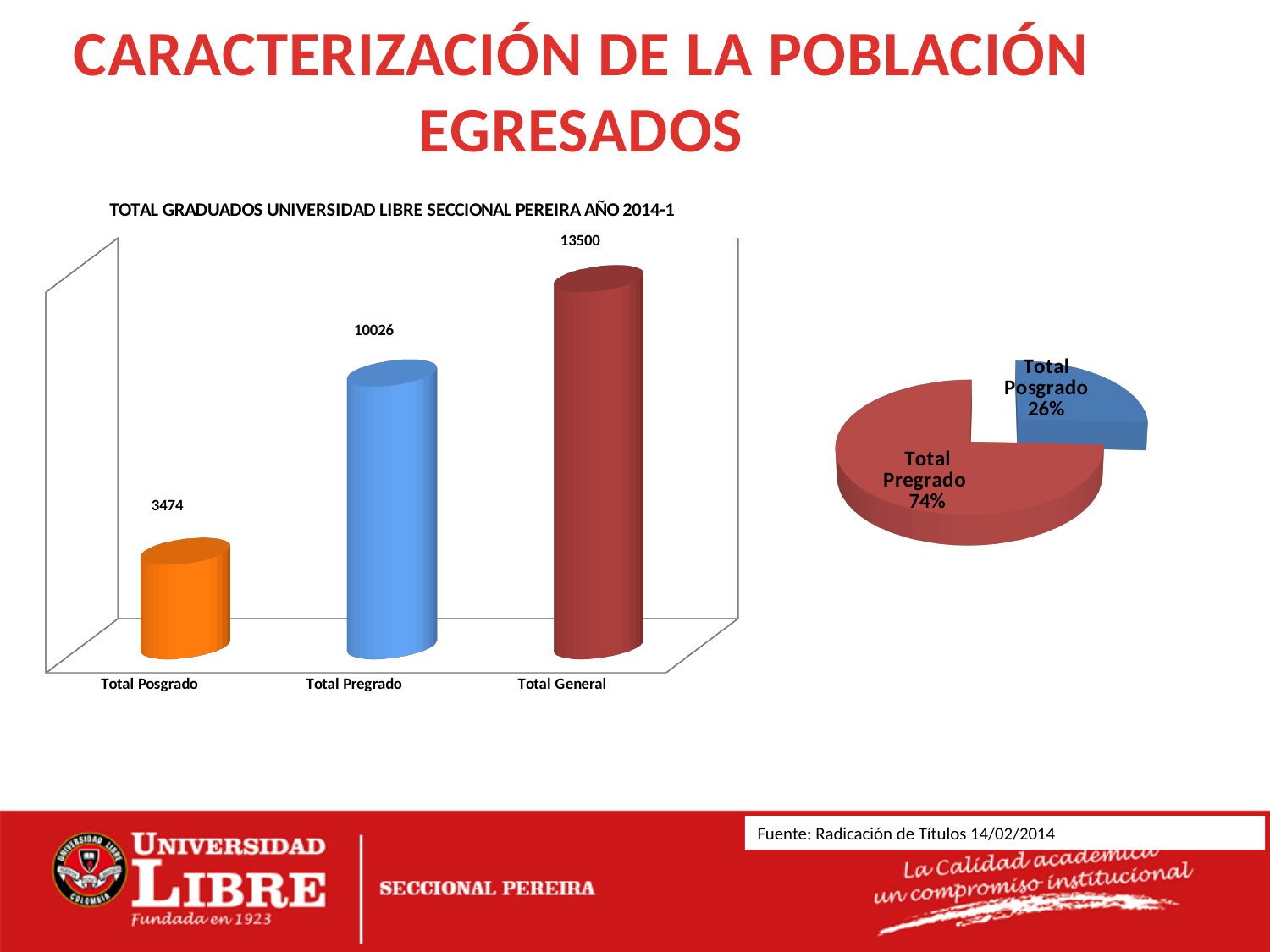
What kind of chart is the chart on the right of the slide? Pie chart In the bar chart on the left, which category has the lowest value? Total Posgrado In the pie chart on the right, what share does Total Pregrado have? 74% In the bar chart 'TOTAL GRADUADOS UNIVERSIDAD LIBRE SECCIONAL PEREIRA AÑO 2014-1', what is the value for Total Posgrado? 3474 In the bar chart on the left, what is the difference between Total Pregrado and Total Posgrado? 6552 In the pie chart on the right, what share does Total Posgrado have? 26% What kind of chart is the chart on the left of the slide? Bar chart In the bar chart 'TOTAL GRADUADOS UNIVERSIDAD LIBRE SECCIONAL PEREIRA AÑO 2014-1', what is the value for Total Pregrado? 10026 In the bar chart on the left, which is larger: Total Pregrado or Total Posgrado? Total Pregrado How many categories are shown in the bar chart on the left? 3 In the bar chart on the left, which category has the highest value? Total General In the bar chart 'TOTAL GRADUADOS UNIVERSIDAD LIBRE SECCIONAL PEREIRA AÑO 2014-1', what is the value for Total General? 13500